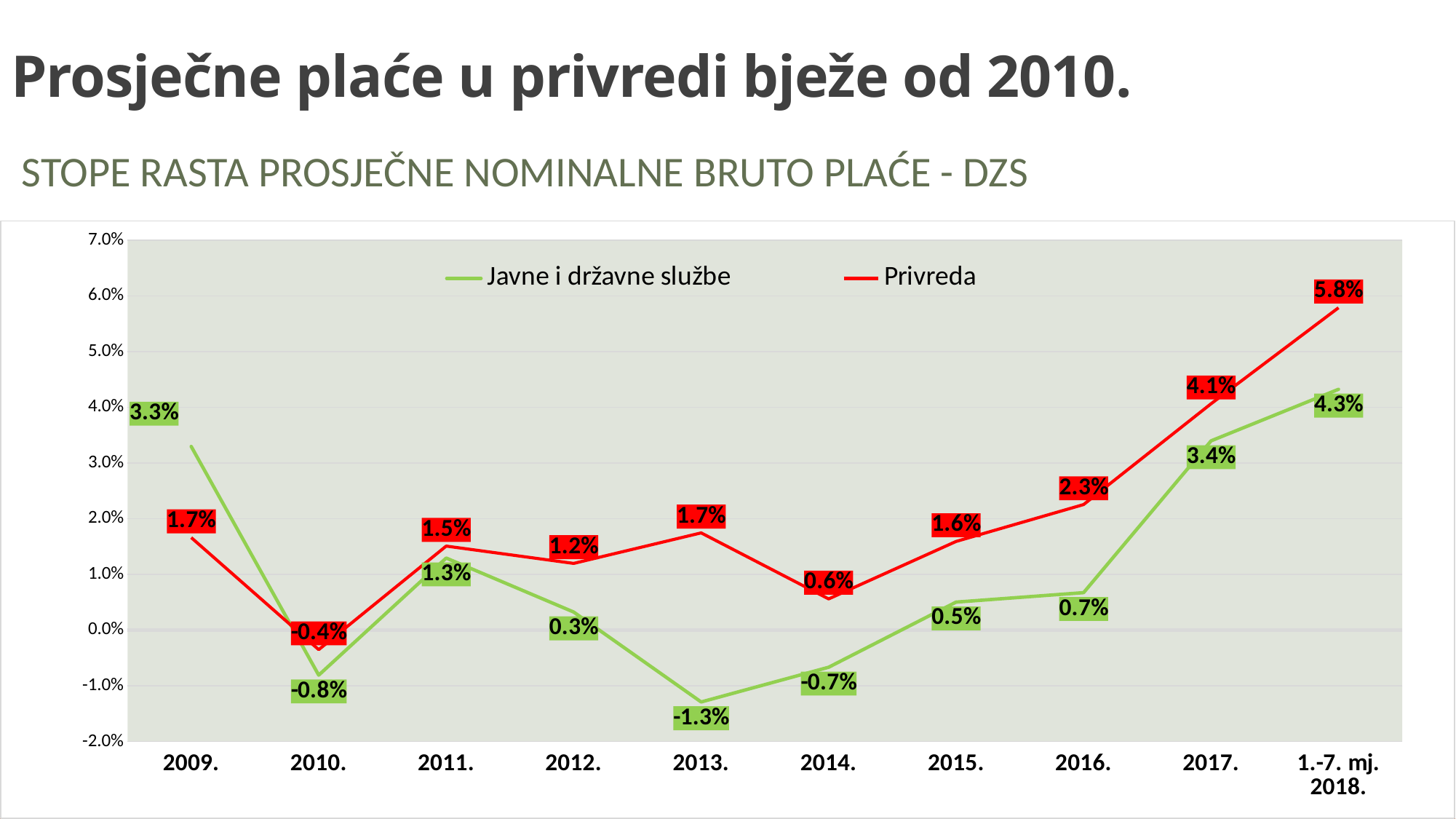
How many series does the legend list? 2 What is the difference between Privreda and Javne i državne službe in 2016.? 1.6% In which period is the Javne i državne službe series at its lowest? 2013. In which period is the Privreda series at its highest? 1.-7. mj. 2018. What is the value for Privreda in 1.-7. mj. 2018.? 5.8% How many time periods are plotted along the x axis? 10 What is the value for Javne i državne službe in 2013.? -1.3% What type of chart is shown on the slide? line chart What colour is the line for Privreda? red Does the Privreda series rise or fall from 2014. to 1.-7. mj. 2018.? rise Which series has the higher value in 2009., Javne i državne službe or Privreda? Javne i državne službe What is the value for Privreda in 2017.? 4.1%